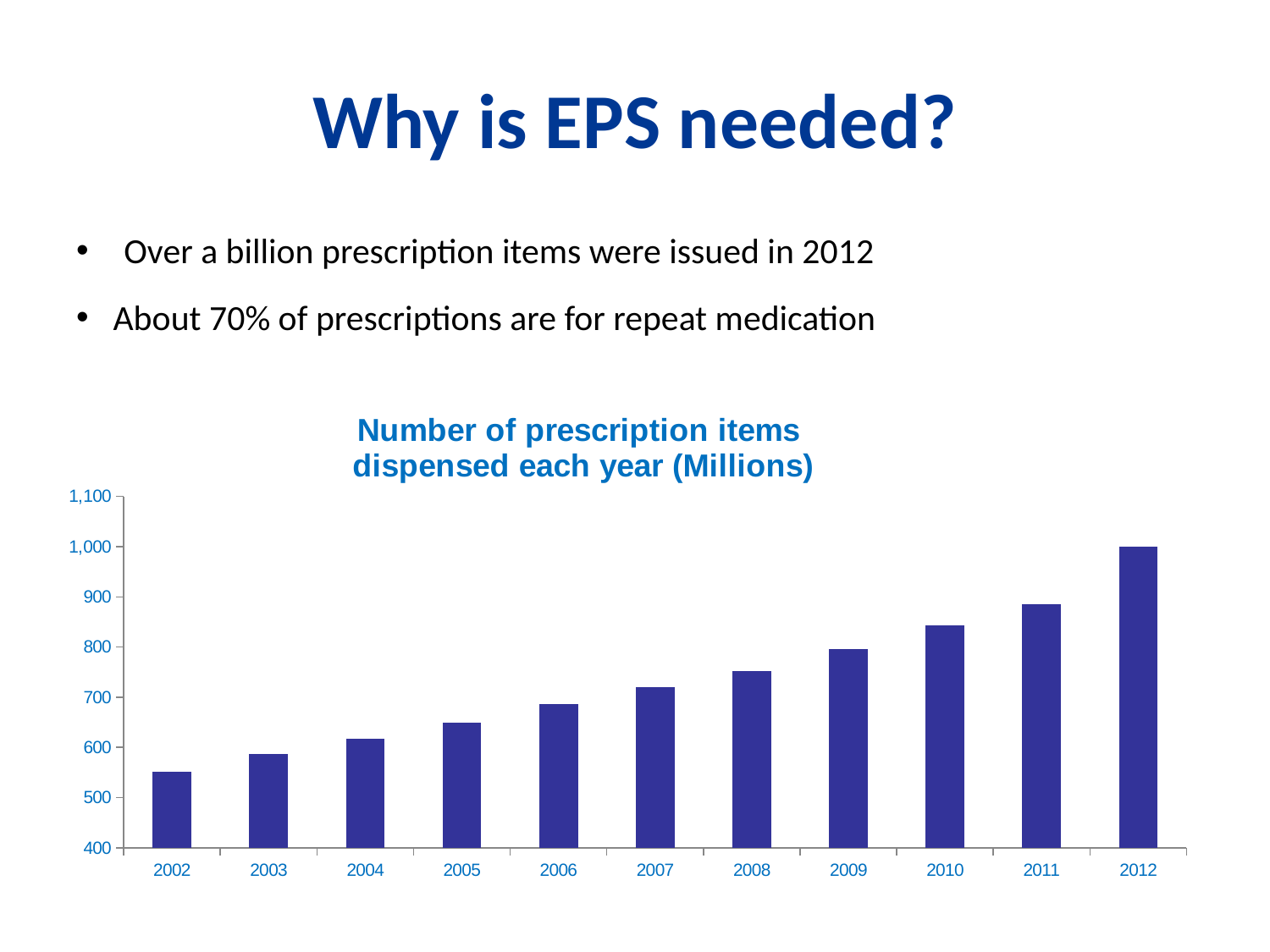
Is the value for 2012 greater or less than 900? greater Is the value for 2005 greater or less than 700? less What kind of chart is shown on the slide? bar chart Is the value for 2007 greater or less than 700? greater Which year has the lowest number of prescription items dispensed? 2002 Which year has the highest number of prescription items dispensed? 2012 Do the values rise or fall from 2002 to 2012? rise What is the title of the chart? Number of prescription items dispensed each year (Millions) Which is larger, the value for 2008 or the value for 2004? 2008 How many years are shown on the x axis of the chart? 11